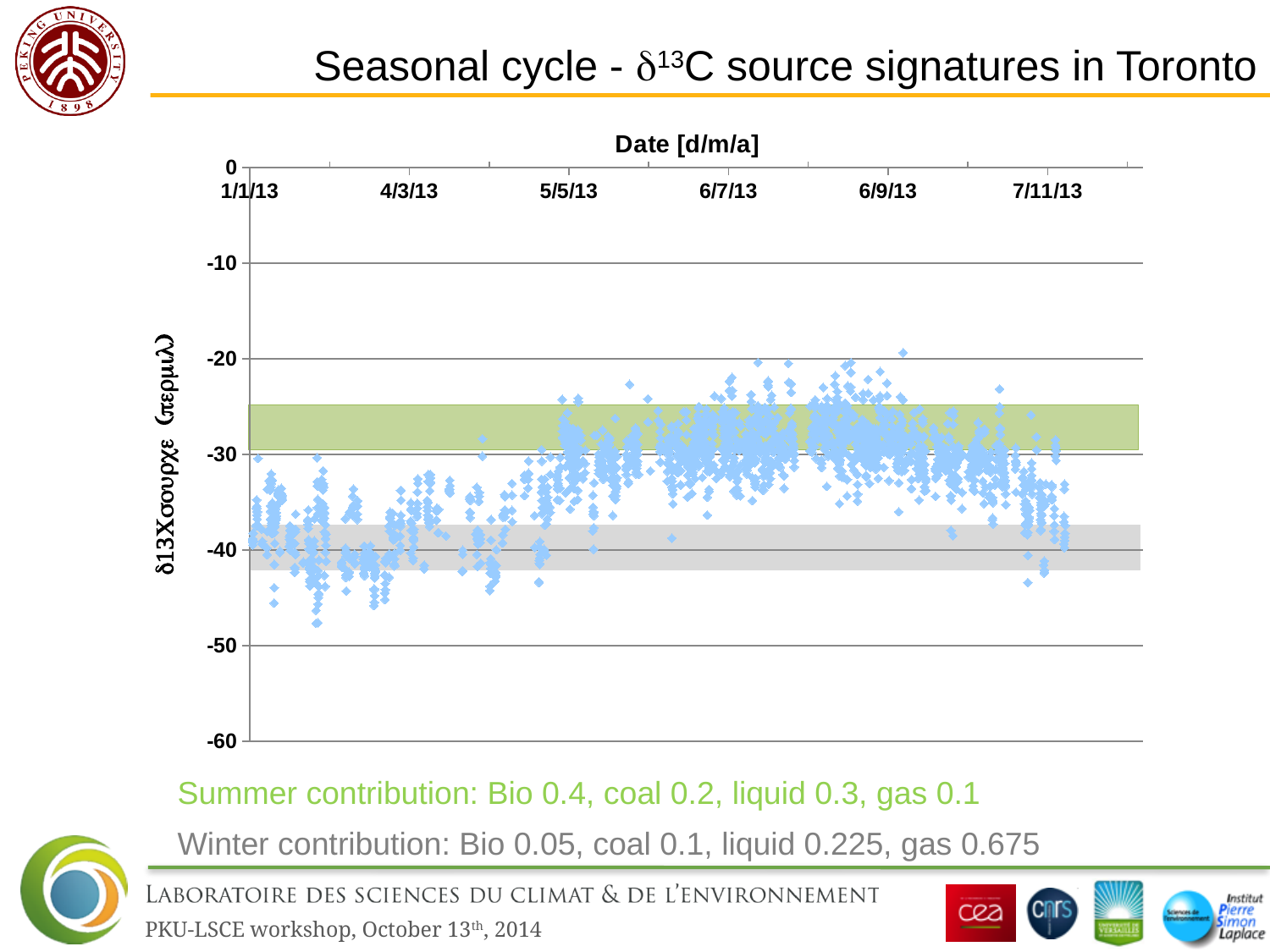
What is the title of the chart's x axis? Date [d/m/a] What is the first date label on the x axis? 1/1/13 How many date labels are shown along the x axis? 6 What kind of chart is shown on the slide? scatter plot What is the lowest value shown on the y axis? -60 Do the lowest data points occur in the first half or the second half of the period shown? first half What colour are the plotted data points? light blue Are the data points around 6/7/13 mostly greater or less than -40? greater Do the highest data points occur in the first half or the second half of the period shown? second half Do the values rise or fall from 1/1/13 to 6/7/13? rise Are the data points around 1/1/13 greater or less than -30? less What is the last date label on the x axis? 7/11/13